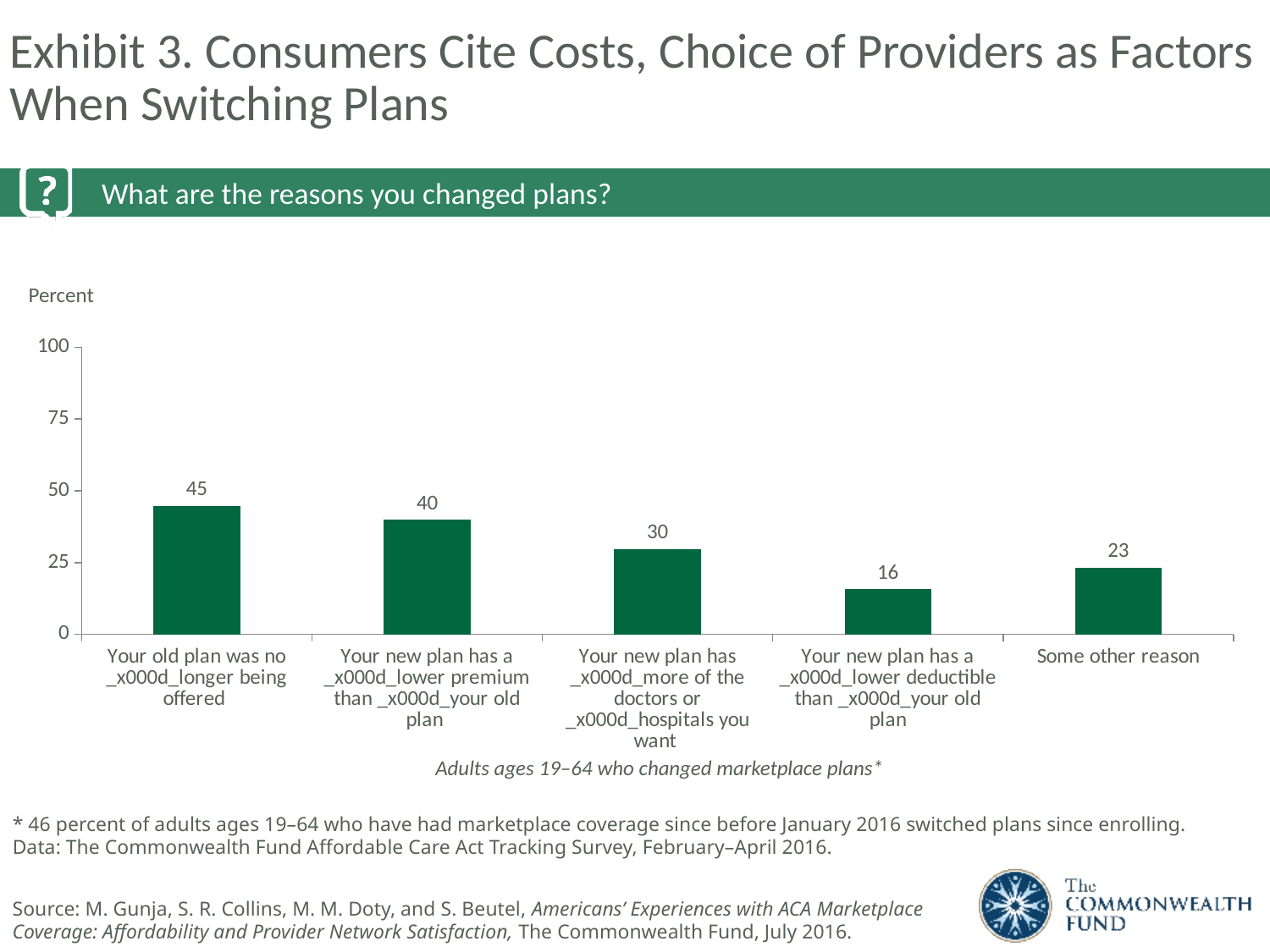
Which reason has the highest value? Your old plan was no longer being offered What is the difference between the values for "Your old plan was no longer being offered" and "Your new plan has a lower premium than your old plan"? 5 Which reason has the lowest value? Your new plan has a lower deductible than your old plan What is the value for "Your new plan has a lower deductible than your old plan"? 16 What is the value for "Some other reason"? 23 What is the value for "Your new plan has a lower premium than your old plan"? 40 How many reasons (categories) are shown in the chart? 5 What is the value for "Your new plan has more of the doctors or hospitals you want"? 30 What kind of chart is shown on the slide? Bar chart Which is larger: the value for "Some other reason" or the value for "Your new plan has a lower deductible than your old plan"? Some other reason What is the value for "Your old plan was no longer being offered"? 45 What is the label on the vertical axis of the chart? Percent